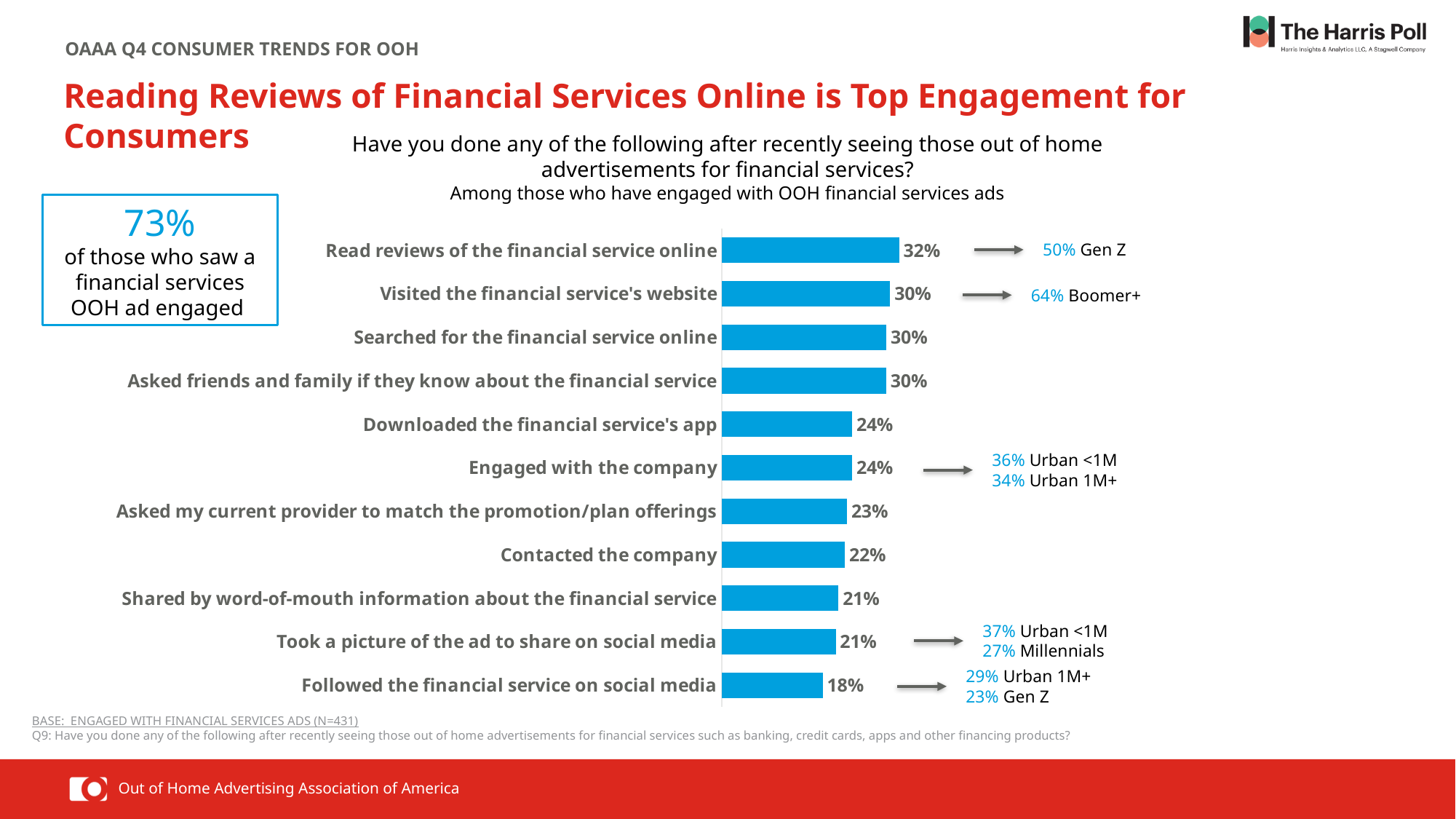
Which action has the highest percentage in the chart? Read reviews of the financial service online What is the difference in percentage points between 'Read reviews of the financial service online' and 'Followed the financial service on social media'? 14 Which is larger: the value for 'Visited the financial service's website' or the value for 'Contacted the company'? Visited the financial service's website What percentage of respondents contacted the company? 22% Which action has the lowest percentage in the chart? Followed the financial service on social media How many actions (categories) are shown in the chart? 11 What is the sample size (N) stated in the base note below the chart? 431 What is the difference in percentage points between 'Asked my current provider to match the promotion/plan offerings' and 'Shared by word-of-mouth information about the financial service'? 2 What percentage of respondents read reviews of the financial service online? 32% What type of chart is shown on the slide? Bar chart What percentage of those who saw a financial services OOH ad engaged, according to the callout box? 73% What percentage of respondents downloaded the financial service's app? 24%